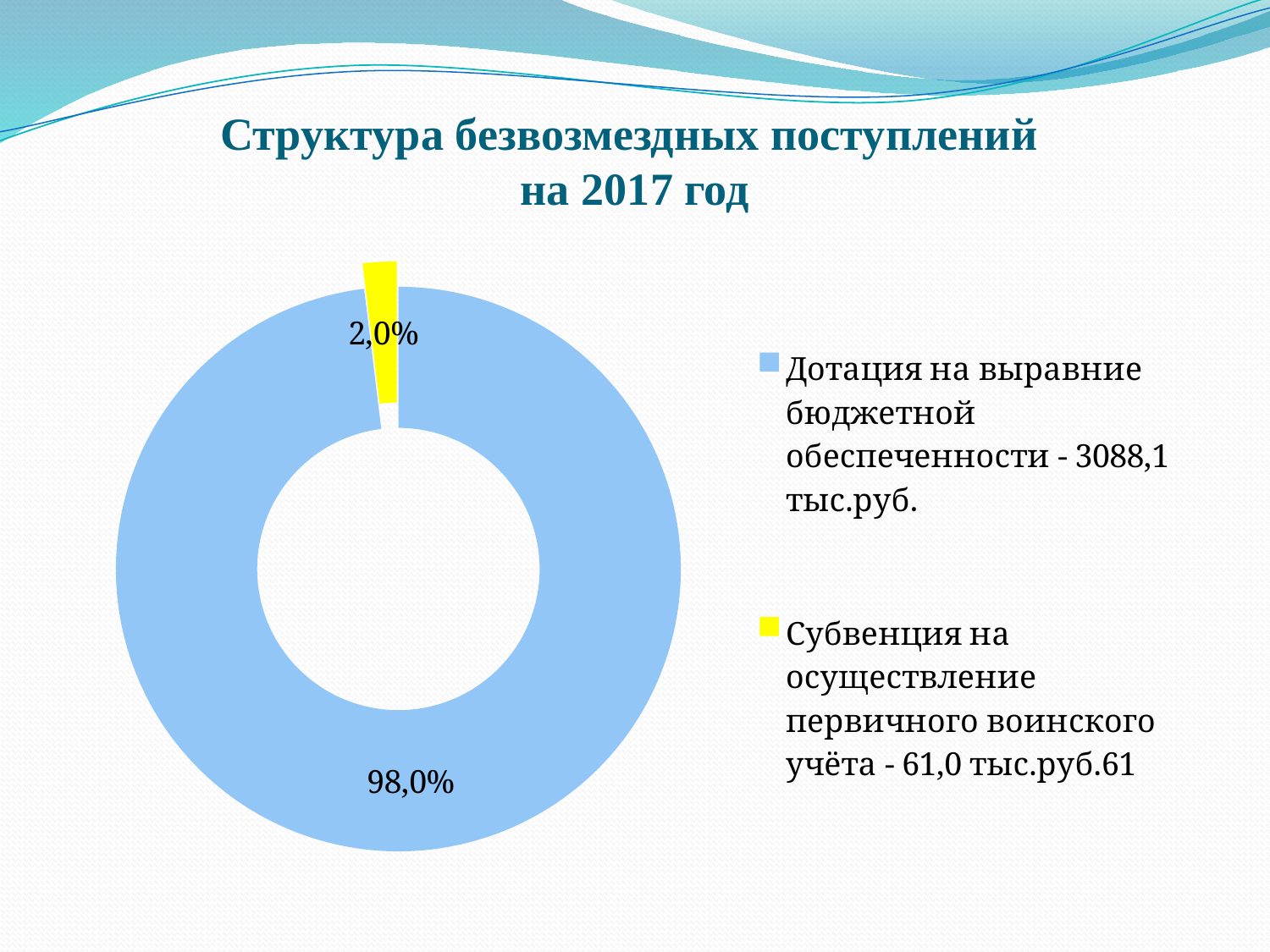
Which category has the smallest slice in the chart? Субвенция на осуществление первичного воинского учёта What share of the chart does the slice for «Дотация на выравнивание бюджетной обеспеченности» represent? 98,0% What kind of chart is shown on the slide? Doughnut (pie) chart What is the difference in percentage points between the two slices of the chart? 96,0% According to the legend, what amount in тыс.руб. corresponds to «Субвенция на осуществление первичного воинского учёта»? 61,0 тыс.руб. According to the legend, what amount in тыс.руб. corresponds to «Дотация на выравнивание бюджетной обеспеченности»? 3088,1 тыс.руб. Which slice is larger: the blue one or the yellow one? The blue one (98,0%) What is the title of the chart on the slide? Структура безвозмездных поступлений на 2017 год Which category has the largest slice in the chart? Дотация на выравние бюджетной обеспеченности How many categories are shown in the chart? 2 What colour is the slice for «Субвенция на осуществление первичного воинского учёта»? Yellow What share of the chart does the slice for «Субвенция на осуществление первичного воинского учёта» represent? 2,0%